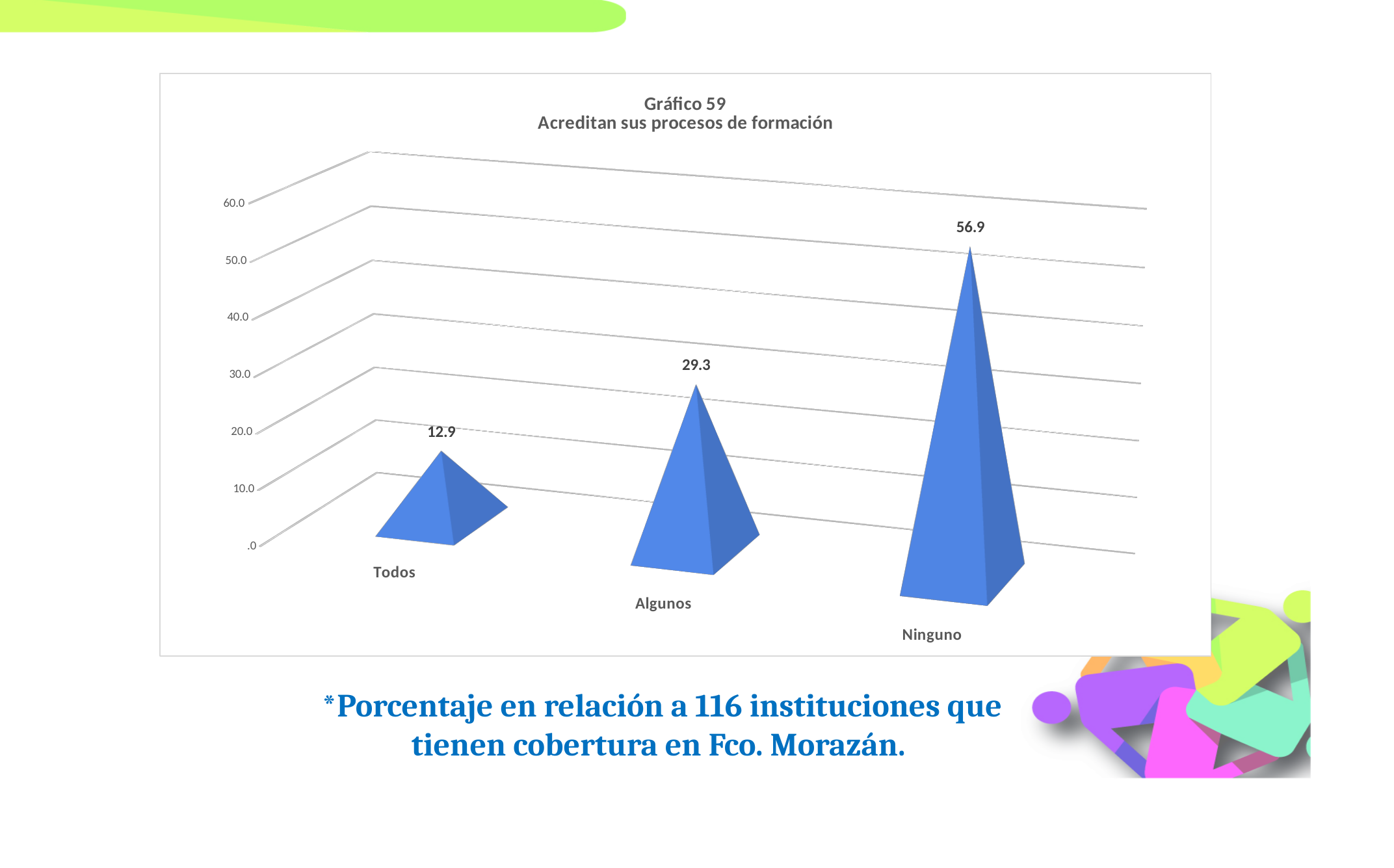
Which category has the highest value? Ninguno What is the value for Todos? 12.9 Which is larger, the value for Todos or the value for Algunos? Algunos What is the value for Algunos? 29.3 What is the difference between the values for Algunos and Todos? 16.4 What kind of chart is shown? bar chart What is the difference between the values for Ninguno and Algunos? 27.6 What is the title of the chart? Gráfico 59 Acreditan sus procesos de formación How many categories are shown on the x axis? 3 What is the value for Ninguno? 56.9 Is the value for Ninguno greater or less than 50.0? greater Which category has the lowest value? Todos